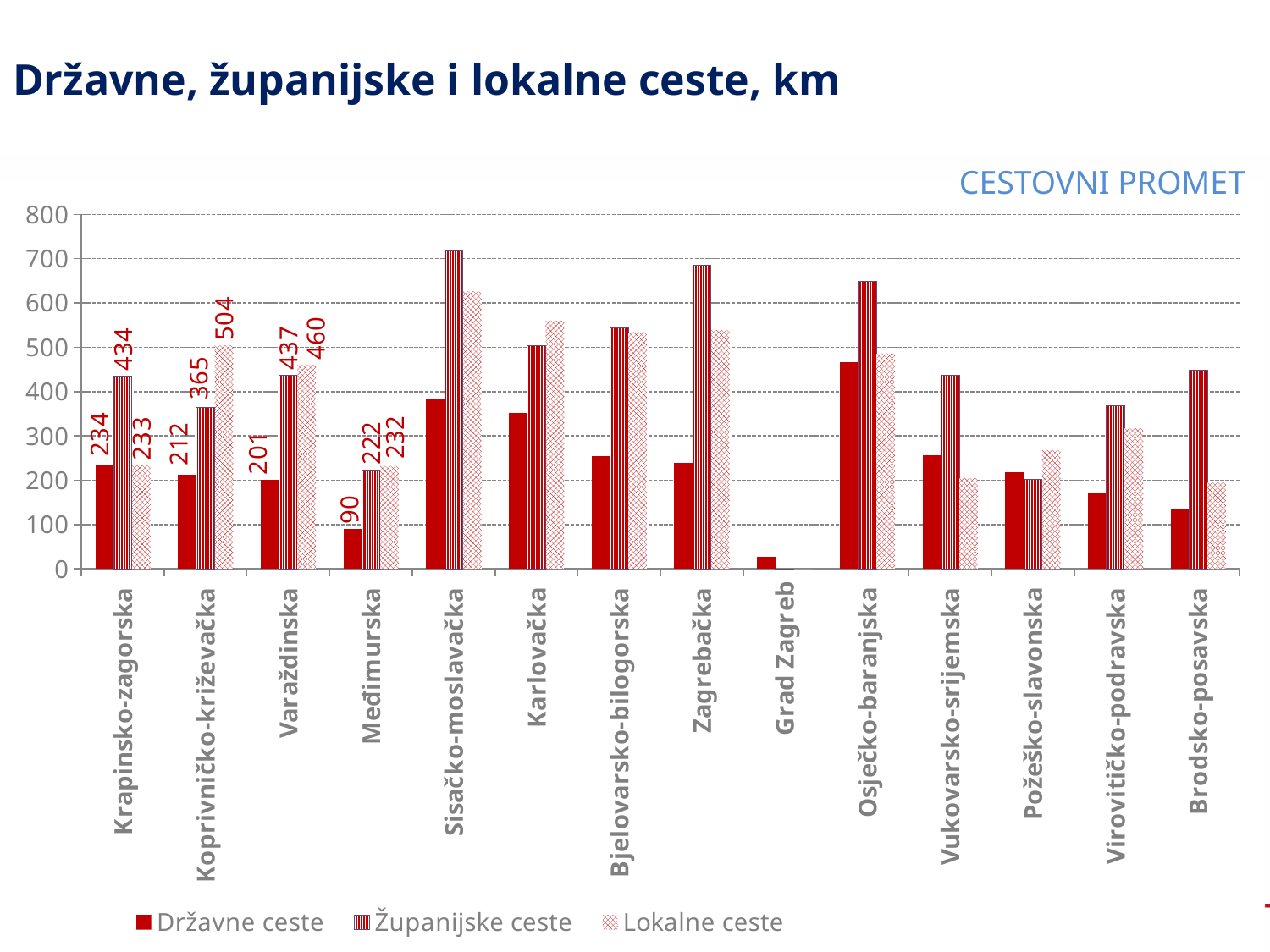
What type of chart is shown on the slide? bar chart How many series does the legend list? 3 What is the total of the three series for Međimurska? 544 What is the value of Županijske ceste for Krapinsko-zagorska? 434 What is the value of Lokalne ceste for Varaždinska? 460 Which category has the highest Županijske ceste value? Sisačko-moslavačka What is the value of Državne ceste for Međimurska? 90 What is the difference between Županijske ceste and Državne ceste for Krapinsko-zagorska? 200 How many categories (counties) are shown on the x axis? 14 What is the value of Lokalne ceste for Koprivničko-križevačka? 504 Which is larger for Koprivničko-križevačka: Županijske ceste or Lokalne ceste? Lokalne ceste Is the Državne ceste value for Osječko-baranjska greater or less than 400? greater